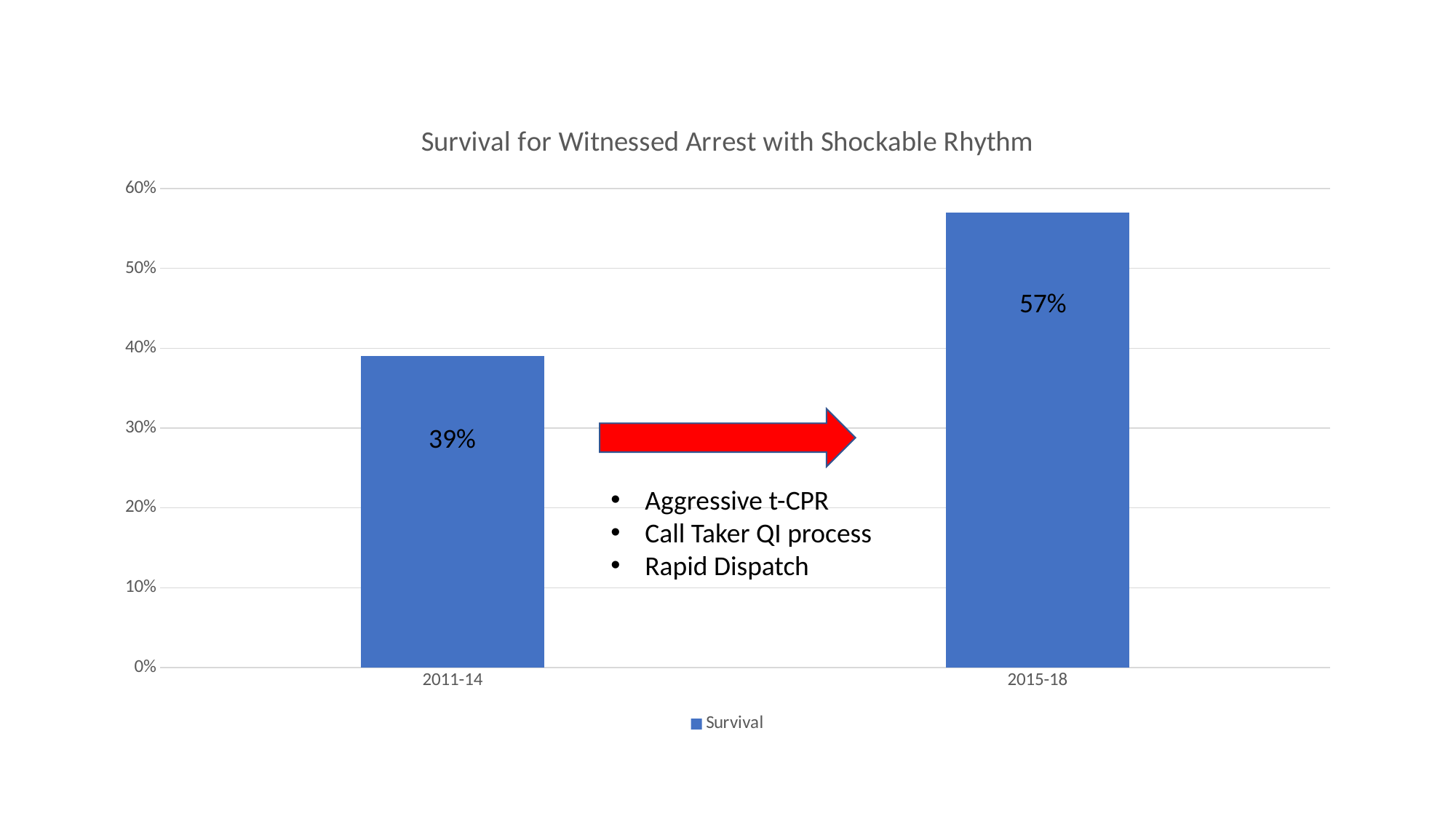
What is the survival value for 2015-18? 57% What kind of chart is shown? bar chart Which period has the lower survival rate? 2011-14 What is the survival value for 2011-14? 39% What is the difference in survival between 2015-18 and 2011-14? 18% Is the survival value for 2011-14 greater or less than 40%? less Is the survival value for 2011-14 larger or smaller than the value for 2015-18? smaller Is the survival value for 2015-18 greater or less than 50%? greater How many periods are shown on the x axis? 2 How many series does the legend list? 1 What is the title of the chart? Survival for Witnessed Arrest with Shockable Rhythm Which period has the higher survival rate? 2015-18